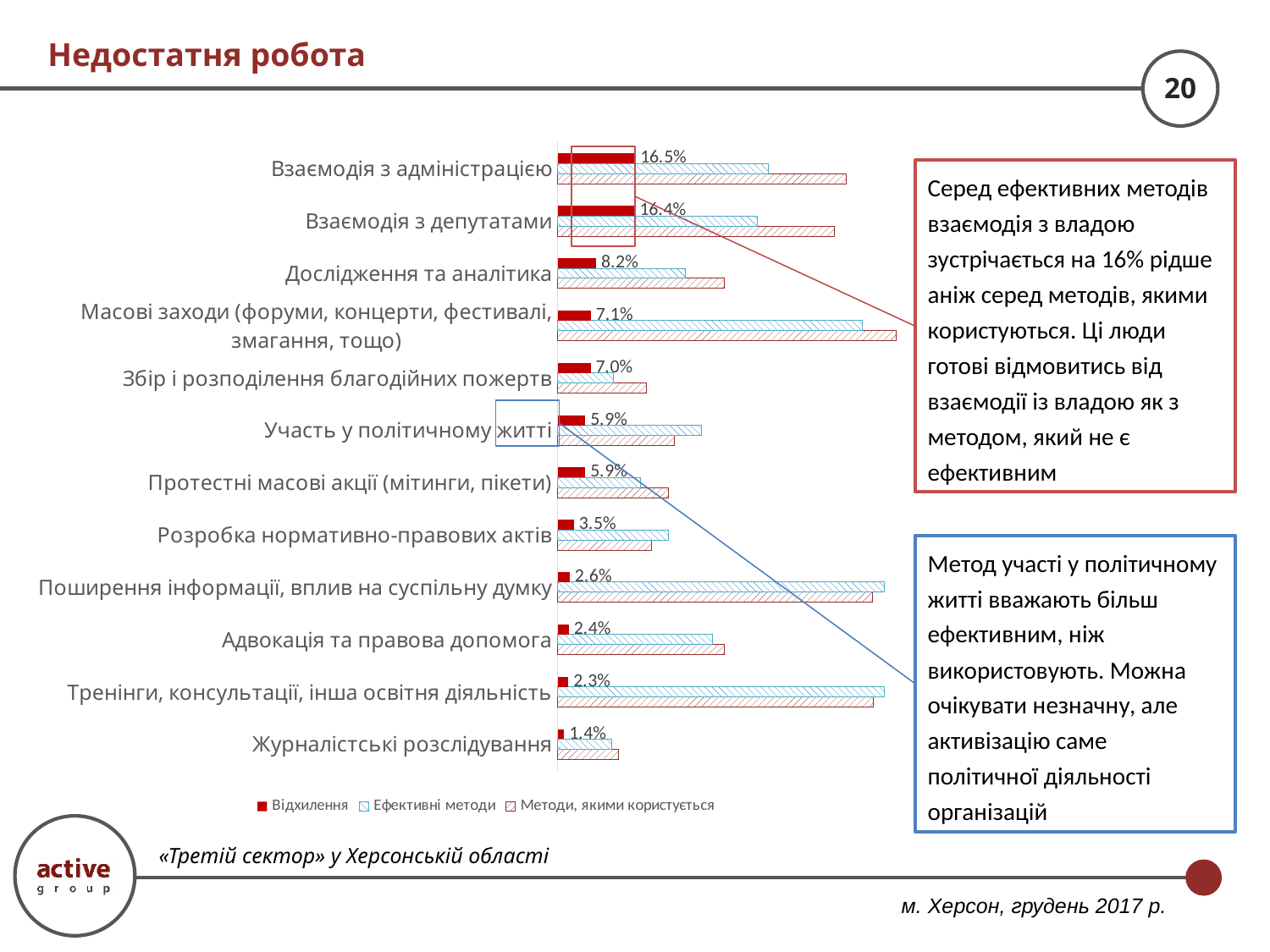
Which category has the lowest Відхилення value? Журналістські розслідування Which series is shown with solid red bars in the legend? Відхилення How many categories are shown on the chart? 12 What is the Відхилення value for Дослідження та аналітика? 8.2% How many series does the legend list? 3 Which has a larger Відхилення value: Дослідження та аналітика or Адвокація та правова допомога? Дослідження та аналітика What kind of chart is shown on the slide? Bar chart What is the Відхилення value for Взаємодія з адміністрацією? 16.5% Which category has the highest Відхилення value? Взаємодія з адміністрацією What is the Відхилення value for Розробка нормативно-правових актів? 3.5% What is the difference between the Відхилення values for Взаємодія з адміністрацією and Дослідження та аналітика? 8.3 percentage points What is the Відхилення value for Журналістські розслідування? 1.4%